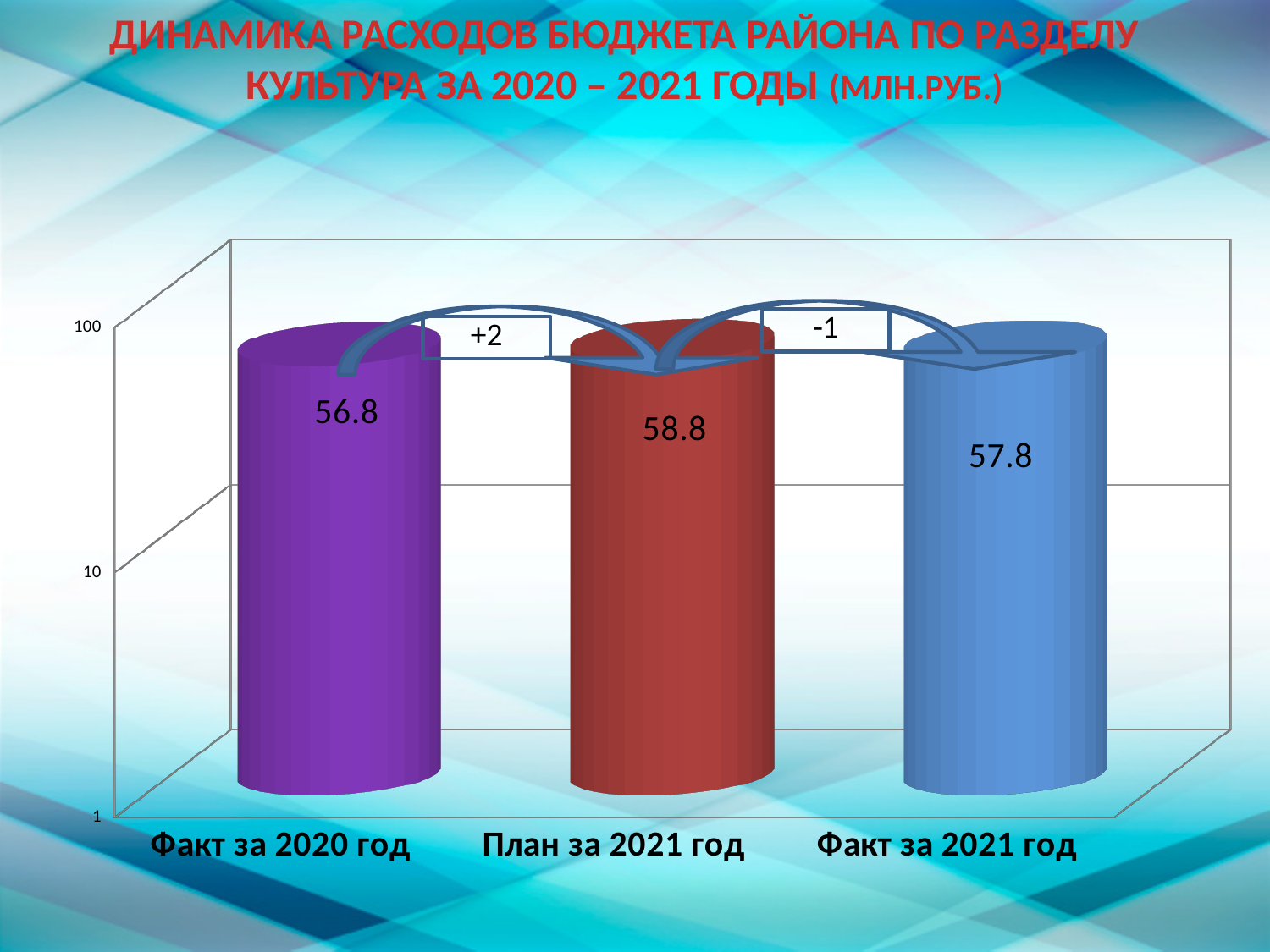
What unit is given in the chart title? млн.руб. Which category has the highest value? План за 2021 год What is the difference between План за 2021 год and Факт за 2021 год? 1 What kind of chart is shown on the slide? bar chart Which is larger, Факт за 2021 год or Факт за 2020 год? Факт за 2021 год What is the value for Факт за 2020 год? 56.8 Which category has the lowest value? Факт за 2020 год What is the difference between План за 2021 год and Факт за 2020 год? 2 Is the value for Факт за 2021 год greater or less than 100? less What is the value for Факт за 2021 год? 57.8 How many categories are shown on the chart? 3 What is the value for План за 2021 год? 58.8